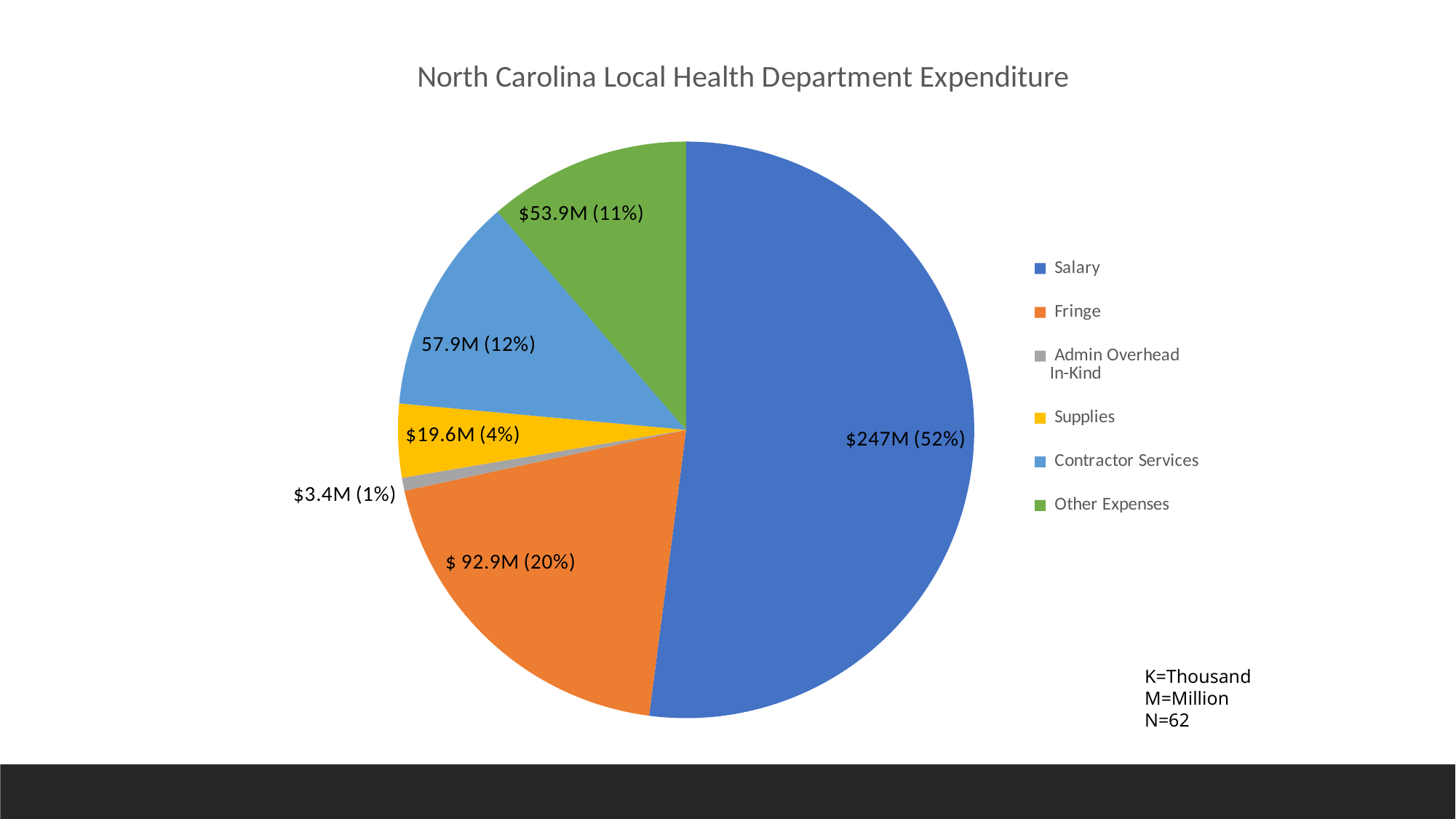
What is the value shown for Salary? $247M (52%) Which category has the largest share of the pie? Salary What is the value shown for Other Expenses? $53.9M (11%) How many categories does the legend list? 6 What is the value shown for Supplies? $19.6M (4%) What is the value shown for Admin Overhead In-Kind? $3.4M (1%) What is the title of the chart? North Carolina Local Health Department Expenditure What is the value shown for Contractor Services? 57.9M (12%) What kind of chart is shown on the slide? pie chart What is the value shown for Fringe? $ 92.9M (20%) Which category has the smallest share of the pie? Admin Overhead In-Kind What percentage share of the pie does Contractor Services have? 12%